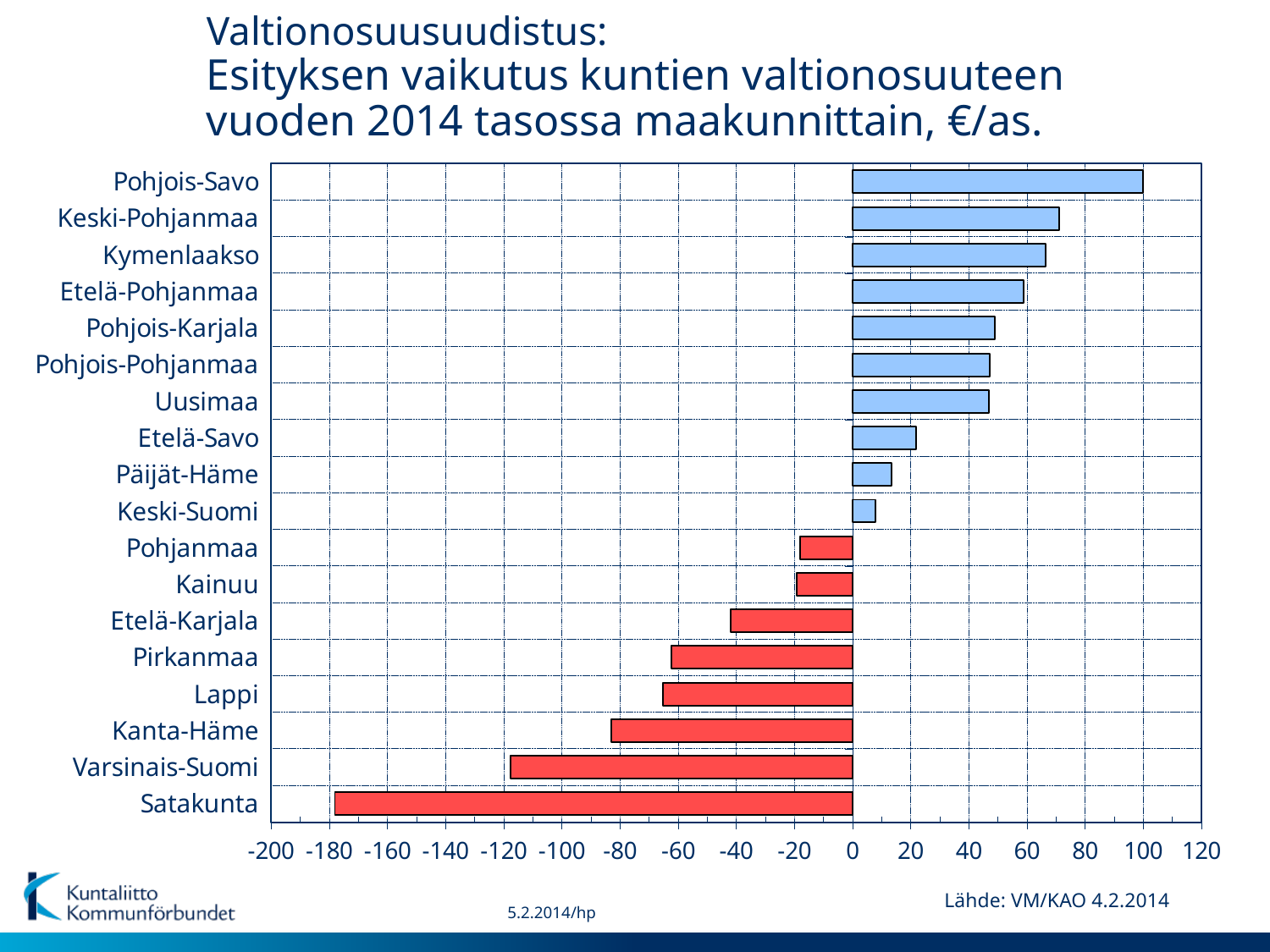
Which has the larger value, Etelä-Karjala or Pirkanmaa? Etelä-Karjala Is the value for Kanta-Häme greater or less than -60? less What colour are the bars with negative values in the chart? red Which region has the highest value in the chart? Pohjois-Savo Which has the larger value, Kymenlaakso or Etelä-Pohjanmaa? Kymenlaakso Is the value for Satakunta greater or less than -160? less Is the value for Keski-Pohjanmaa greater or less than 60? greater Which region has the lowest value in the chart? Satakunta How many regions (maakunnat) are plotted in the chart? 18 What kind of chart is shown on the slide? bar chart